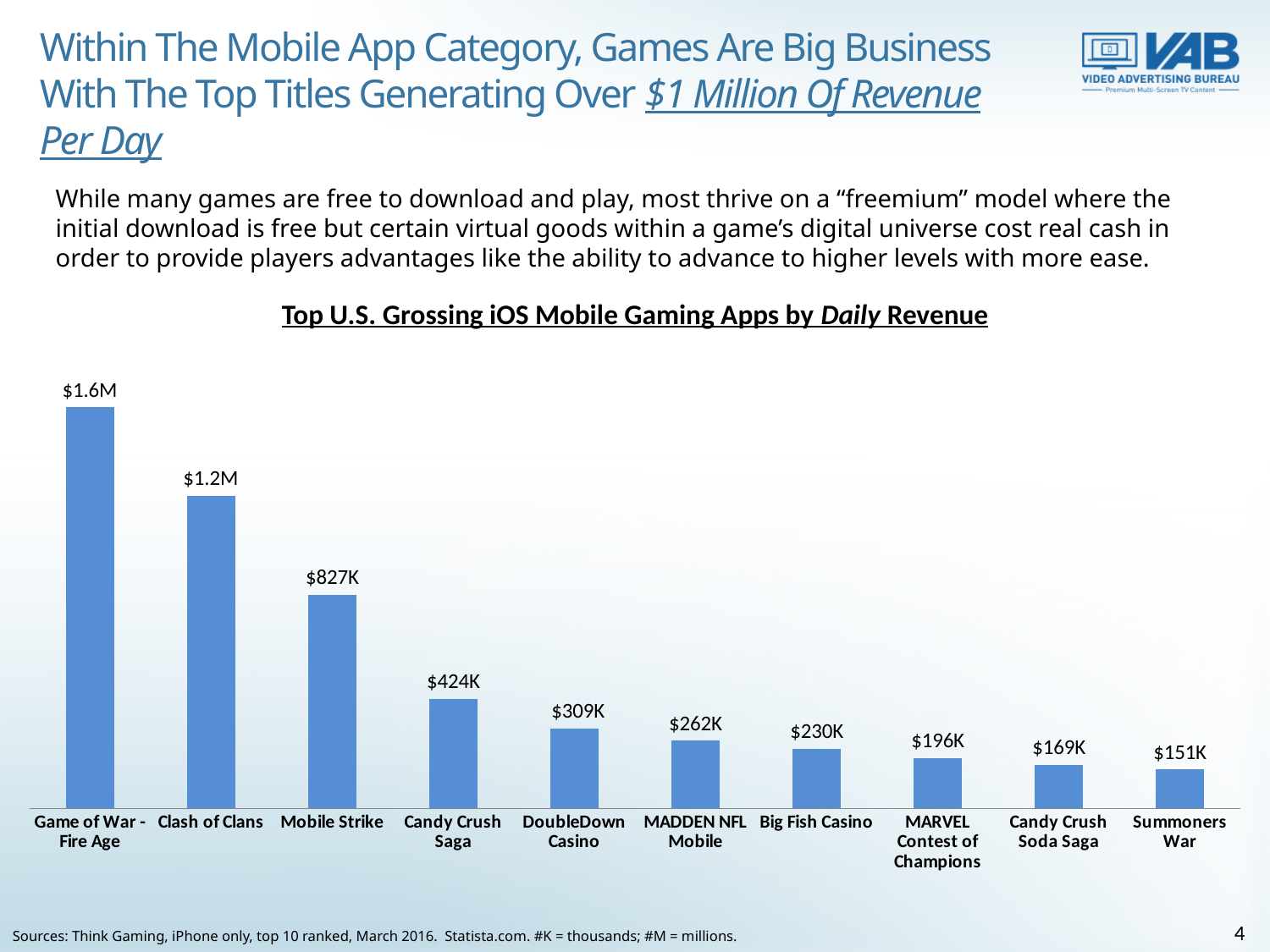
Which app has the lowest daily revenue? Summoners War What is the daily revenue for Mobile Strike? $827K What is the daily revenue for Clash of Clans? $1.2M What is the difference in daily revenue between Candy Crush Saga and DoubleDown Casino? $115K What is the daily revenue for Summoners War? $151K How many apps are shown in the chart? 10 Do the values rise or fall moving from left to right across the chart? Fall What is the daily revenue for Big Fish Casino? $230K What is the difference in daily revenue between MARVEL Contest of Champions and Candy Crush Soda Saga? $27K Which app has the highest daily revenue? Game of War - Fire Age Which has higher daily revenue, MADDEN NFL Mobile or Big Fish Casino? MADDEN NFL Mobile What type of chart is used to show the daily revenue of the apps? Bar chart